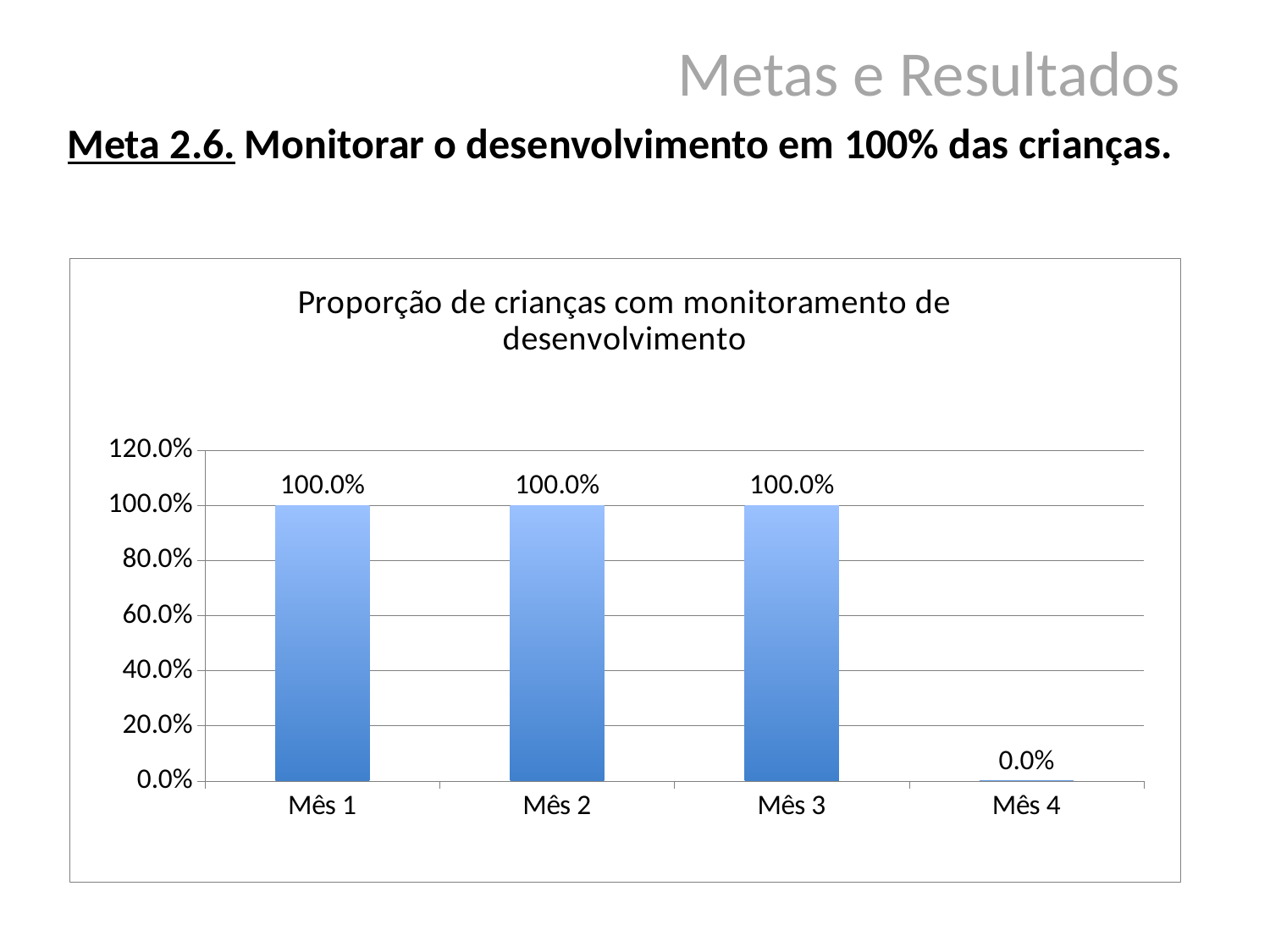
What is the difference between the values for Mês 3 and Mês 4? 100.0% Is the value for Mês 1 greater or less than 80.0%? greater What kind of chart is shown on the slide? bar chart What is the value for Mês 2? 100.0% What is the value for Mês 3? 100.0% What is the value for Mês 1? 100.0% Which category has the lowest value? Mês 4 What is the title of the chart? Proporção de crianças com monitoramento de desenvolvimento What is the value for Mês 4? 0.0% Which is larger, the value for Mês 2 or the value for Mês 4? Mês 2 What is the highest value shown on the y axis? 120.0% How many categories are shown on the x axis? 4